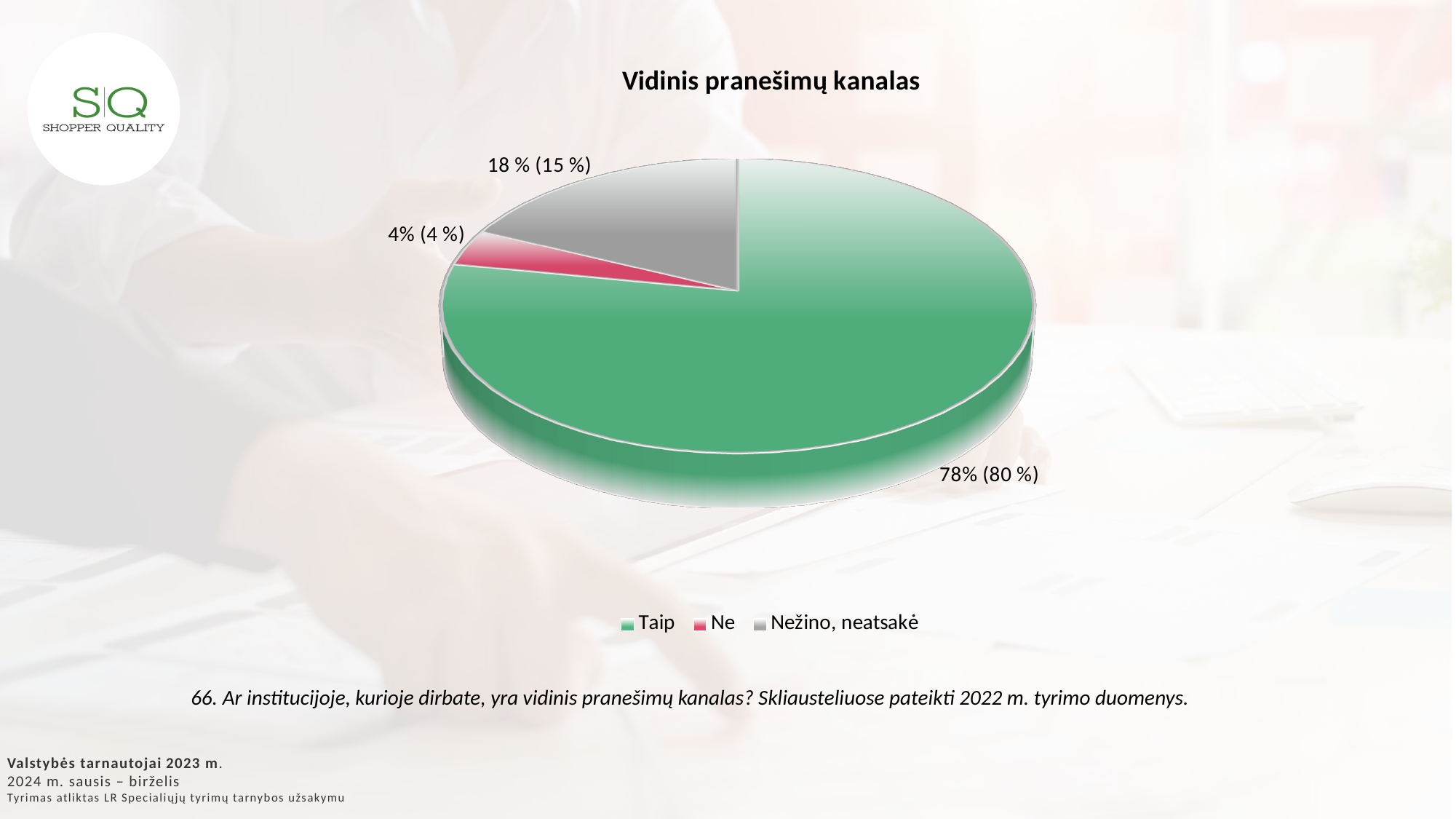
What kind of chart is shown on the slide? pie chart Which category has the smallest slice of the pie? Ne What is the difference in percentage points between the "Taip" value (78%) and the "Nežino, neatsakė" value (18 %)? 60 percentage points What is the title of the chart? Vidinis pranešimų kanalas What percentage is shown for the "Nežino, neatsakė" slice (the first value, outside the parentheses)? 18 % What value in parentheses (2022 data) is shown for the "Nežino, neatsakė" slice? 15 % Which category has the largest slice of the pie? Taip How many slices does the pie chart have? 3 What value in parentheses (2022 data) is shown for the "Taip" slice? 80 % What percentage is shown for the "Ne" slice (the first value, outside the parentheses)? 4% What percentage is shown for the "Taip" slice (the first value, outside the parentheses)? 78% Which slice is larger, "Ne" or "Nežino, neatsakė"? Nežino, neatsakė